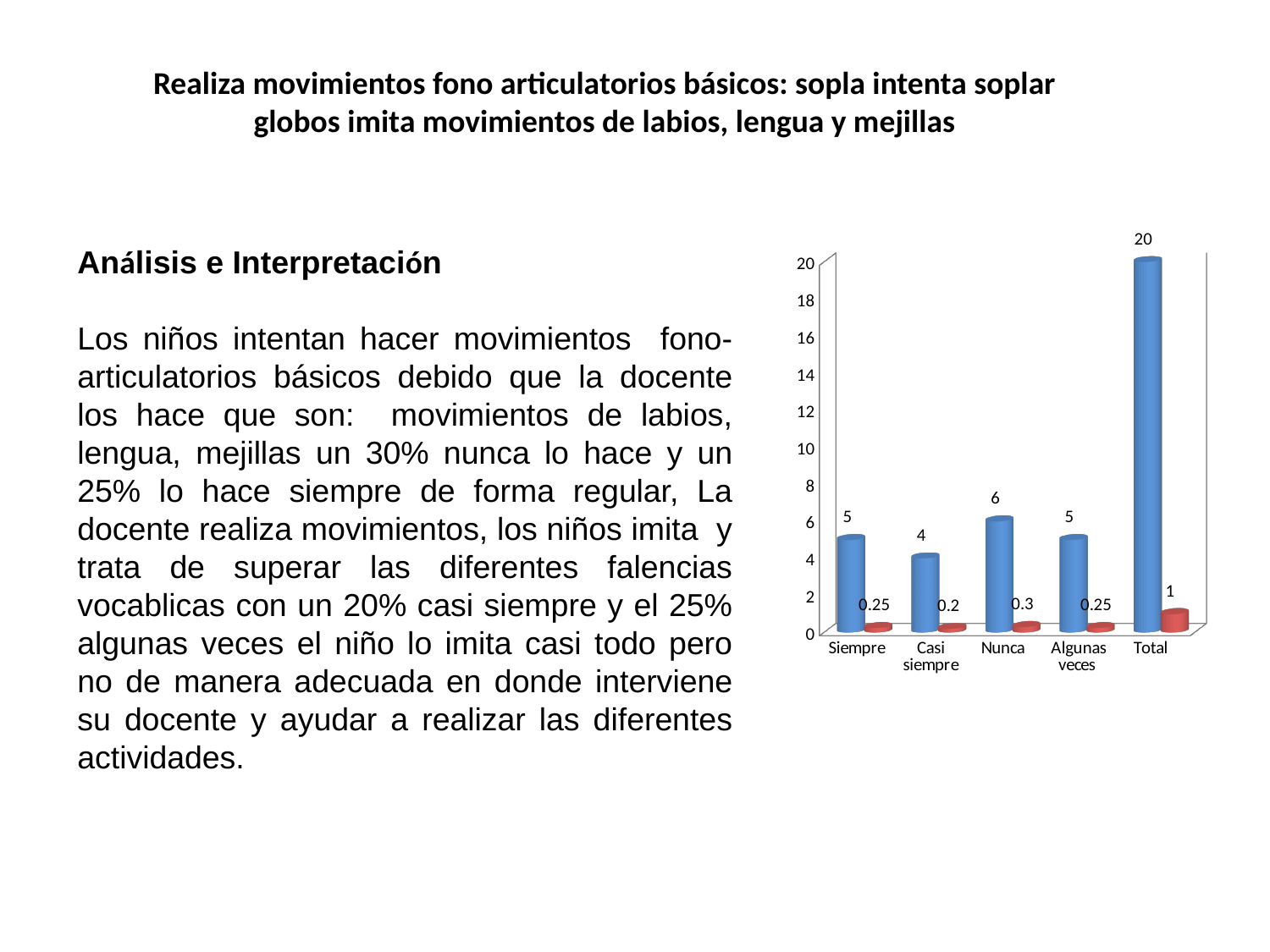
Excluding Total, which category has the highest blue bar? Nunca What is the value of the blue bar for Nunca? 6 What kind of chart is shown on the slide? bar chart Is the blue bar for Total greater or less than 10? greater Which is larger, the blue bar for Siempre or the blue bar for Casi siempre? Siempre What is the difference between the blue bar values for Nunca and Casi siempre? 2 What is the value of the red bar for Algunas veces? 0.25 What is the value of the red bar for Nunca? 0.3 How many categories are shown on the x axis? 5 What is the value of the blue bar for Total? 20 Which category has the lowest blue bar? Casi siempre What is the value of the blue bar for Casi siempre? 4